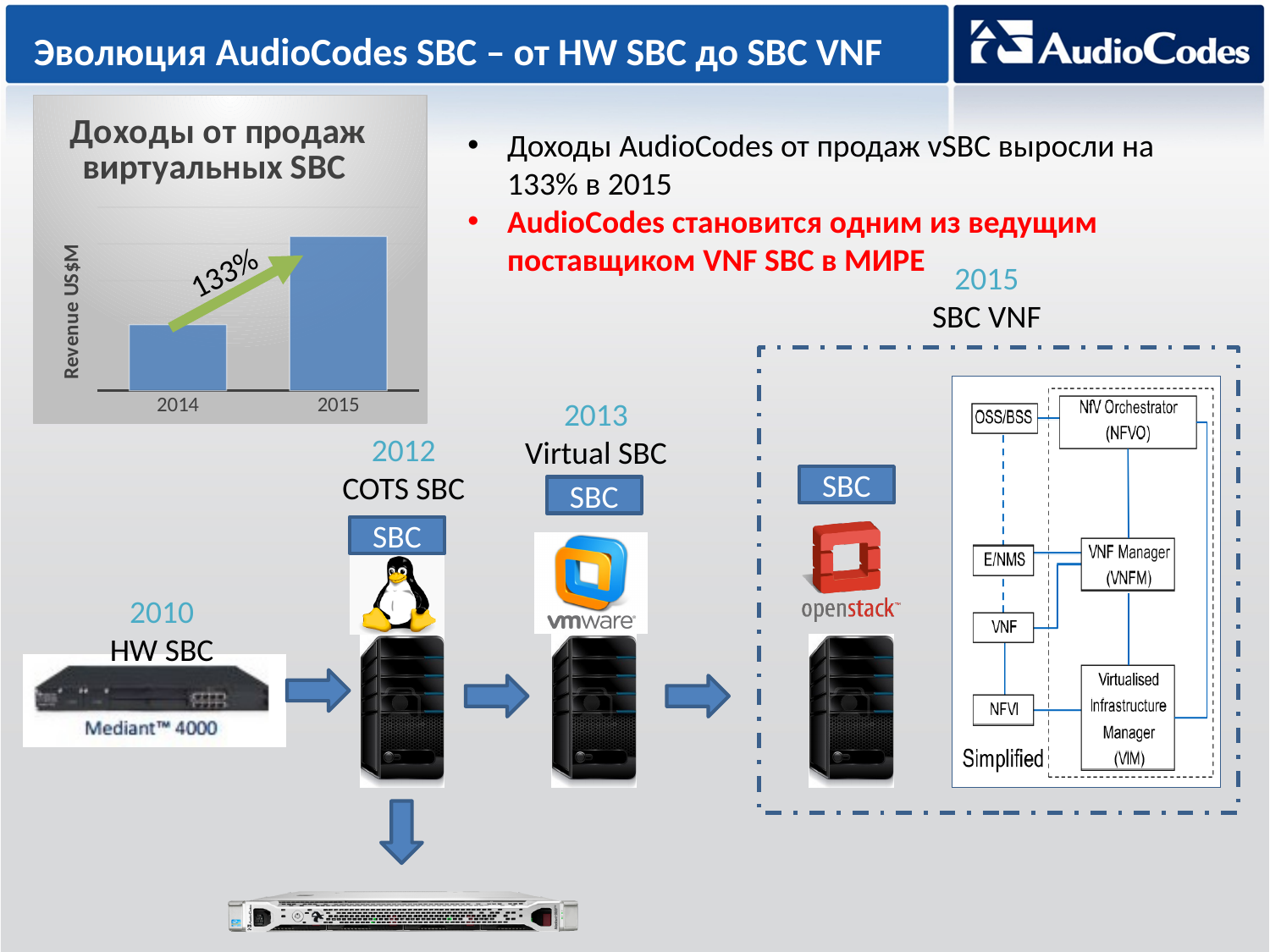
What percentage growth is written on the arrow in the chart? 133% Do the values in the chart rise or fall from 2014 to 2015? rise Which year has the highest revenue in the chart? 2015 What kind of chart is shown on the slide? bar chart Which is larger in the chart, the bar for 2014 or the bar for 2015? 2015 What is the title of the chart? Доходы от продаж виртуальных SBC What is the label of the vertical axis of the chart? Revenue US$M Which year has the lowest revenue in the chart? 2014 How many bars (categories) does the chart show? 2